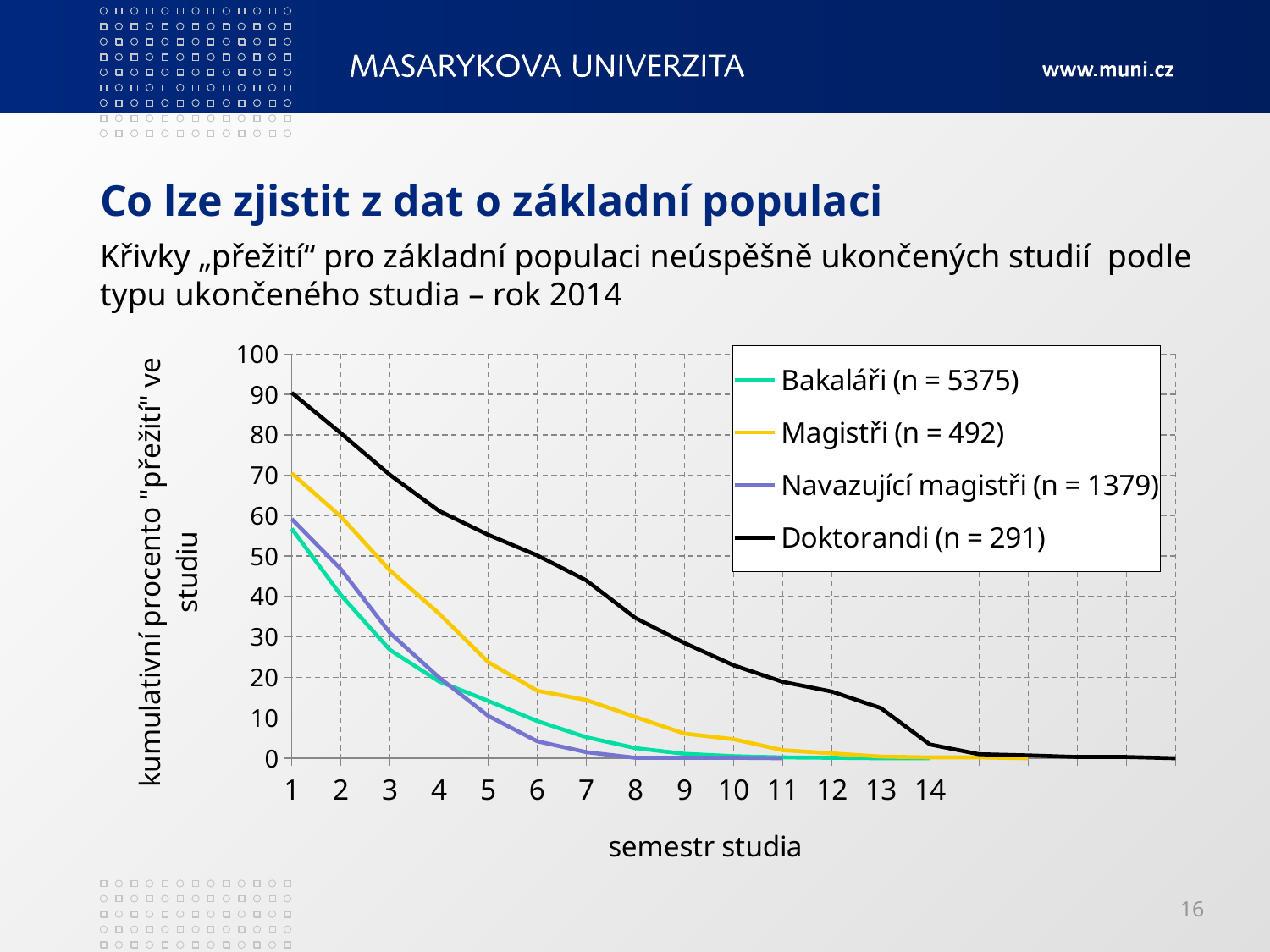
At semester 3, which is larger: the value for Magistři or the value for Bakaláři? Magistři Is the value for Doktorandi at semester 8 greater or less than 40? less How many series does the legend list? 4 Is the value for Doktorandi at semester 2 greater or less than 70? greater What is the title of the x axis? semestr studia Which series has the highest value at semester 1? Doktorandi (n = 291) Do the values for Doktorandi rise or fall as the semester number increases? fall Which series has the lowest value at semester 6? Navazující magistři (n = 1379) What kind of chart is shown on the slide? line chart What is the sample size (n) given in the legend for Bakaláři? 5375 Is the value for Bakaláři at semester 5 greater or less than 20? less How many semesters are labelled on the x axis? 14